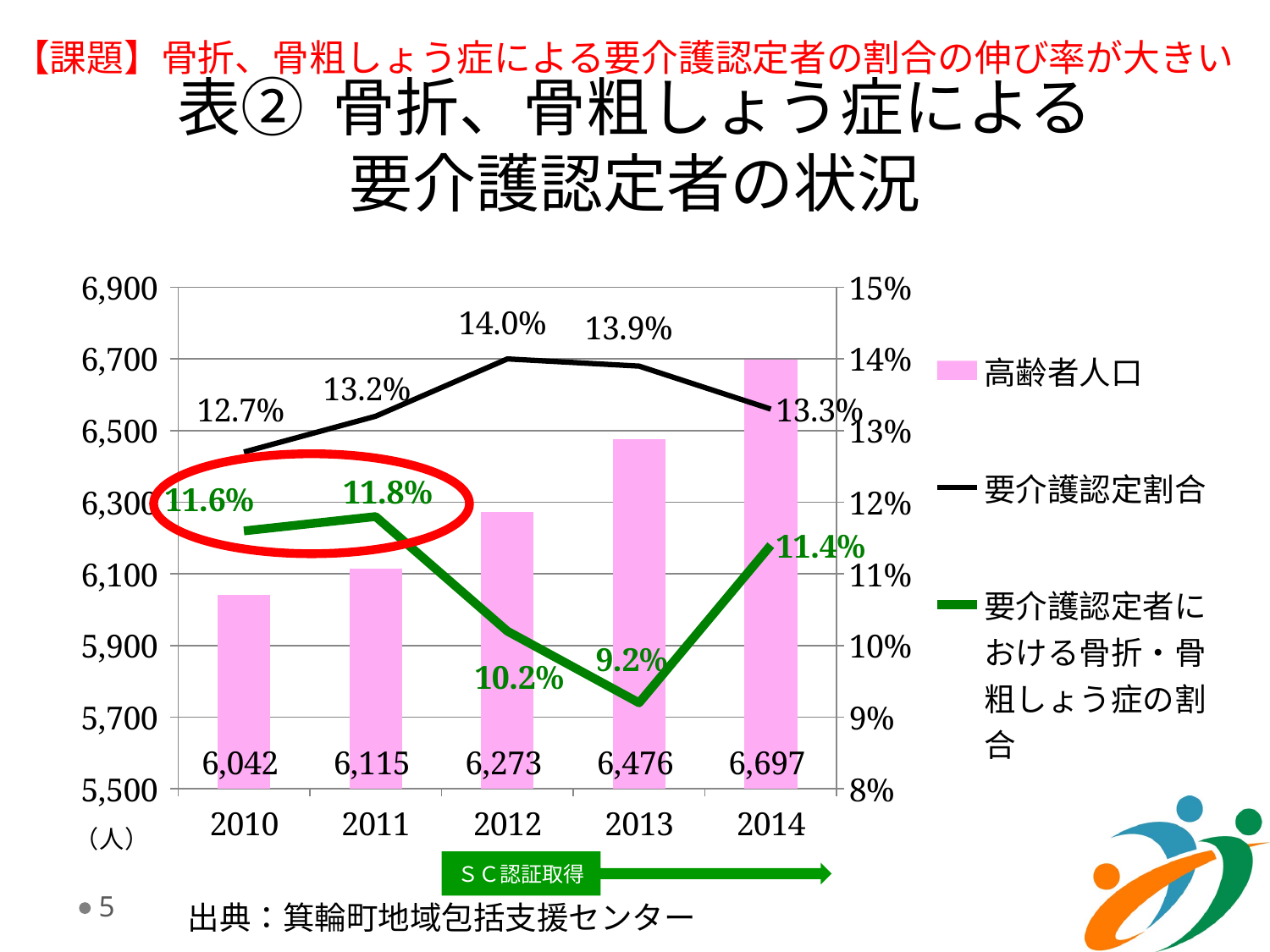
What colour are the 高齢者人口 bars? pink What is the value of 要介護認定割合 for 2012? 14.0% What is the value of 要介護認定者における骨折・骨粗しょう症の割合 for 2013? 9.2% What is the difference in 高齢者人口 between 2014 and 2010? 655 Does 高齢者人口 rise or fall from 2010 to 2014? rise What is the value of 高齢者人口 for 2014? 6,697 How many years are shown on the x axis? 5 How many series does the legend list? 3 Which year has the highest 要介護認定割合? 2012 What is the value of 高齢者人口 for 2010? 6,042 Which is larger, the 要介護認定者における骨折・骨粗しょう症の割合 for 2011 or for 2014? 2011 Which year has the lowest 要介護認定者における骨折・骨粗しょう症の割合? 2013